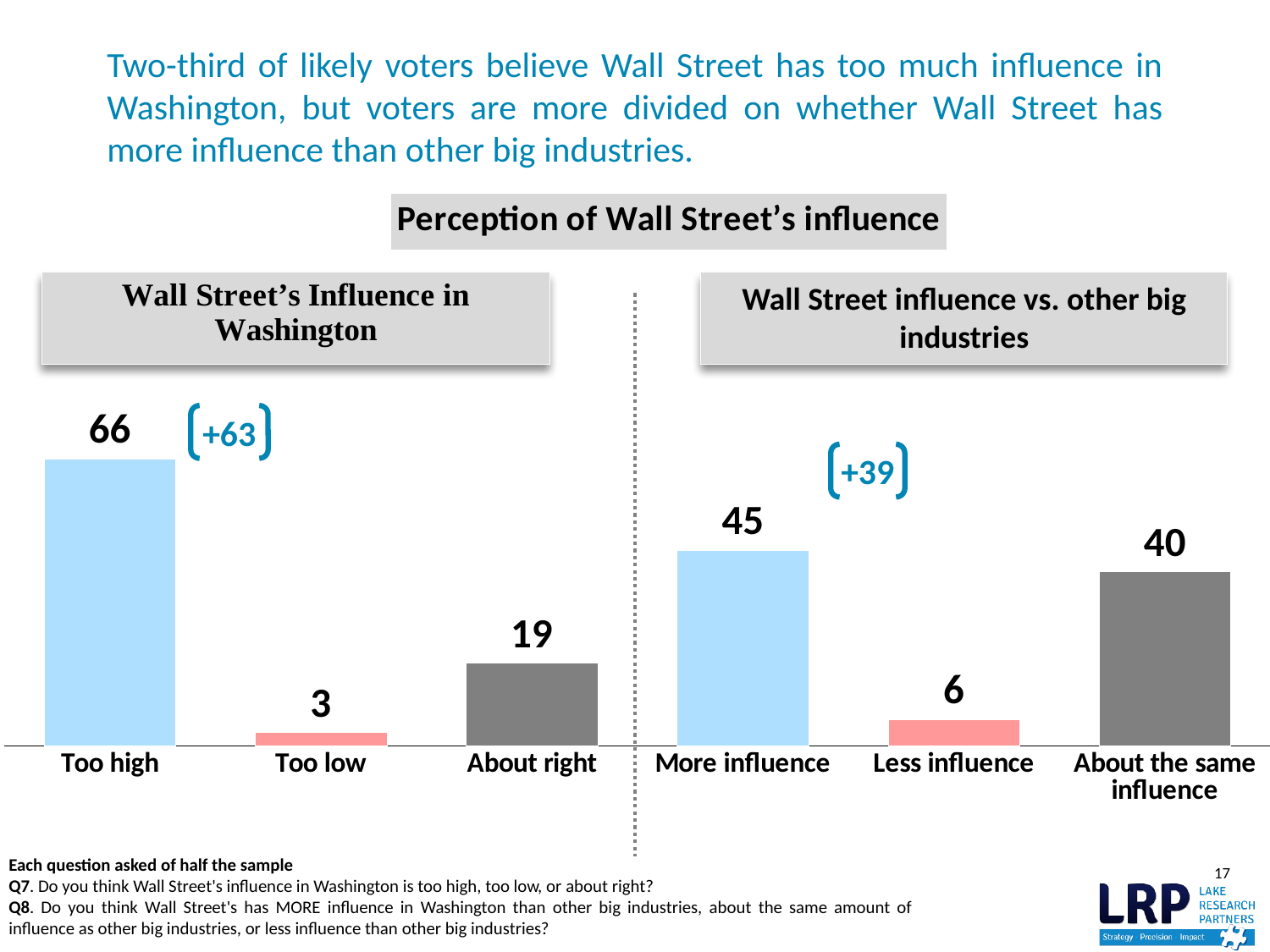
In the 'Wall Street's Influence in Washington' chart, what is the value for 'About right'? 19 In the 'Wall Street influence vs. other big industries' chart, what is the difference between 'More influence' and 'About the same influence'? 5 In the 'Wall Street's Influence in Washington' chart, what is the value for 'Too high'? 66 What type of chart is used for 'Wall Street influence vs. other big industries'? Bar chart In the 'Wall Street influence vs. other big industries' chart, what is the value for 'About the same influence'? 40 How many categories are shown in the 'Wall Street's Influence in Washington' chart? 3 In the 'Wall Street influence vs. other big industries' chart, what is the value for 'Less influence'? 6 In the 'Wall Street's Influence in Washington' chart, what is the difference between 'Too high' and 'About right'? 47 In the 'Wall Street influence vs. other big industries' chart, which category has the highest value? More influence What net figure is shown in brackets next to the 'Too high' bar in the 'Wall Street's Influence in Washington' chart? +63 In the 'Wall Street's Influence in Washington' chart, which category has the lowest value? Too low In the 'Wall Street influence vs. other big industries' chart, which is larger: 'More influence' or 'Less influence'? More influence